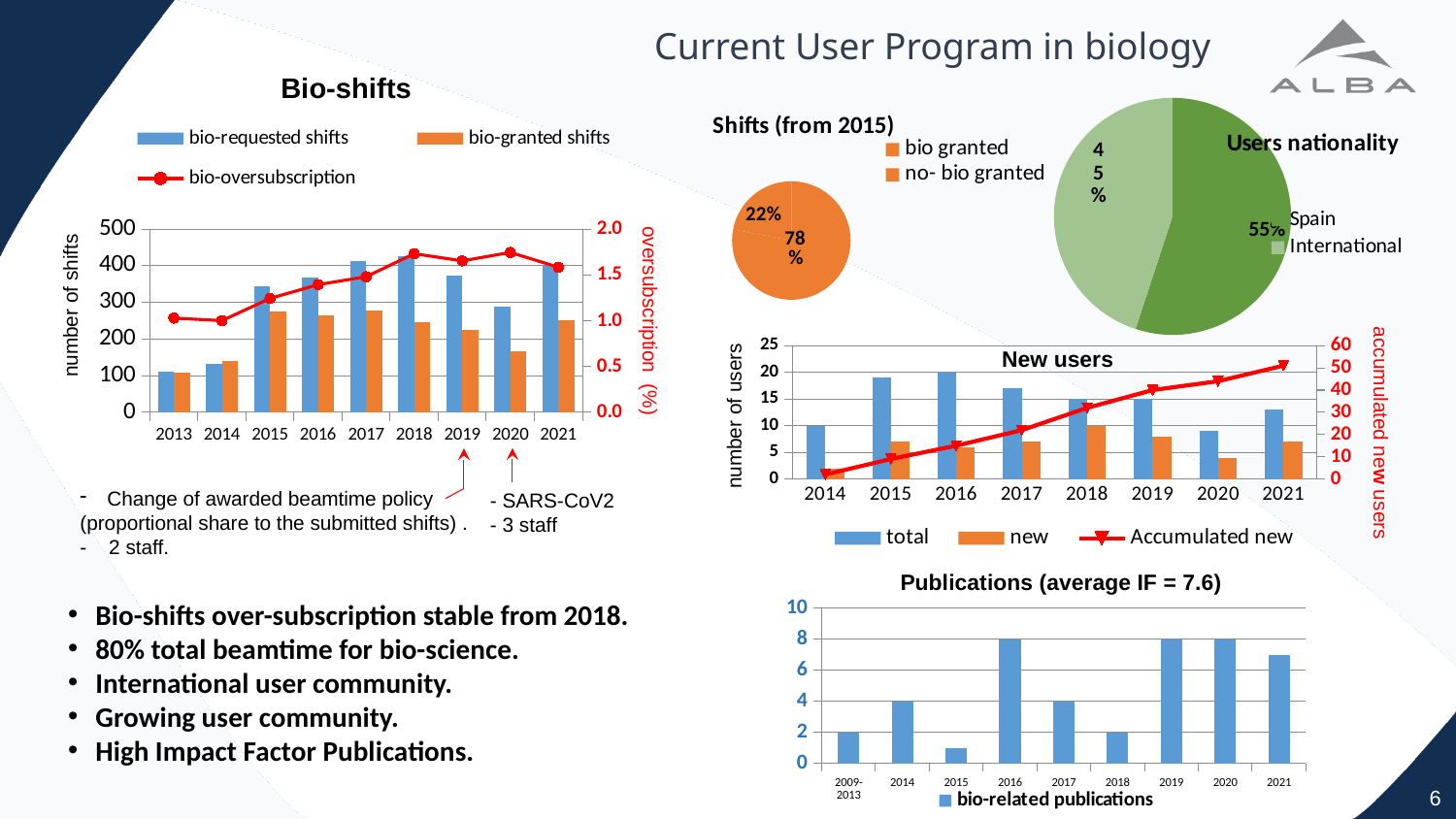
In the "Users nationality" pie chart, what share of users is from Spain? 55% In the "Publications (average IF = 7.6)" chart, how many categories are shown on the x axis? 9 In the "Shifts (from 2015)" pie chart, what share of shifts is no-bio granted? 22% In the "New users" chart, does the Accumulated new line rise or fall from 2014 to 2021? rise In the "Publications (average IF = 7.6)" chart, how many bio-related publications are shown for 2016? 8 In the "Publications (average IF = 7.6)" chart, how many bio-related publications are shown for 2014? 4 In the "Bio-shifts" chart, is the value of bio-requested shifts for 2018 greater or less than 300? greater In the "New users" chart, how many years are shown on the x axis? 8 In the "Bio-shifts" chart, how many series does the legend list? 3 In the "Users nationality" pie chart, which slice is larger, Spain or International? Spain In the "Publications (average IF = 7.6)" chart, which category has the lowest number of publications? 2015 In the "Shifts (from 2015)" pie chart, what share of shifts is bio granted? 78%